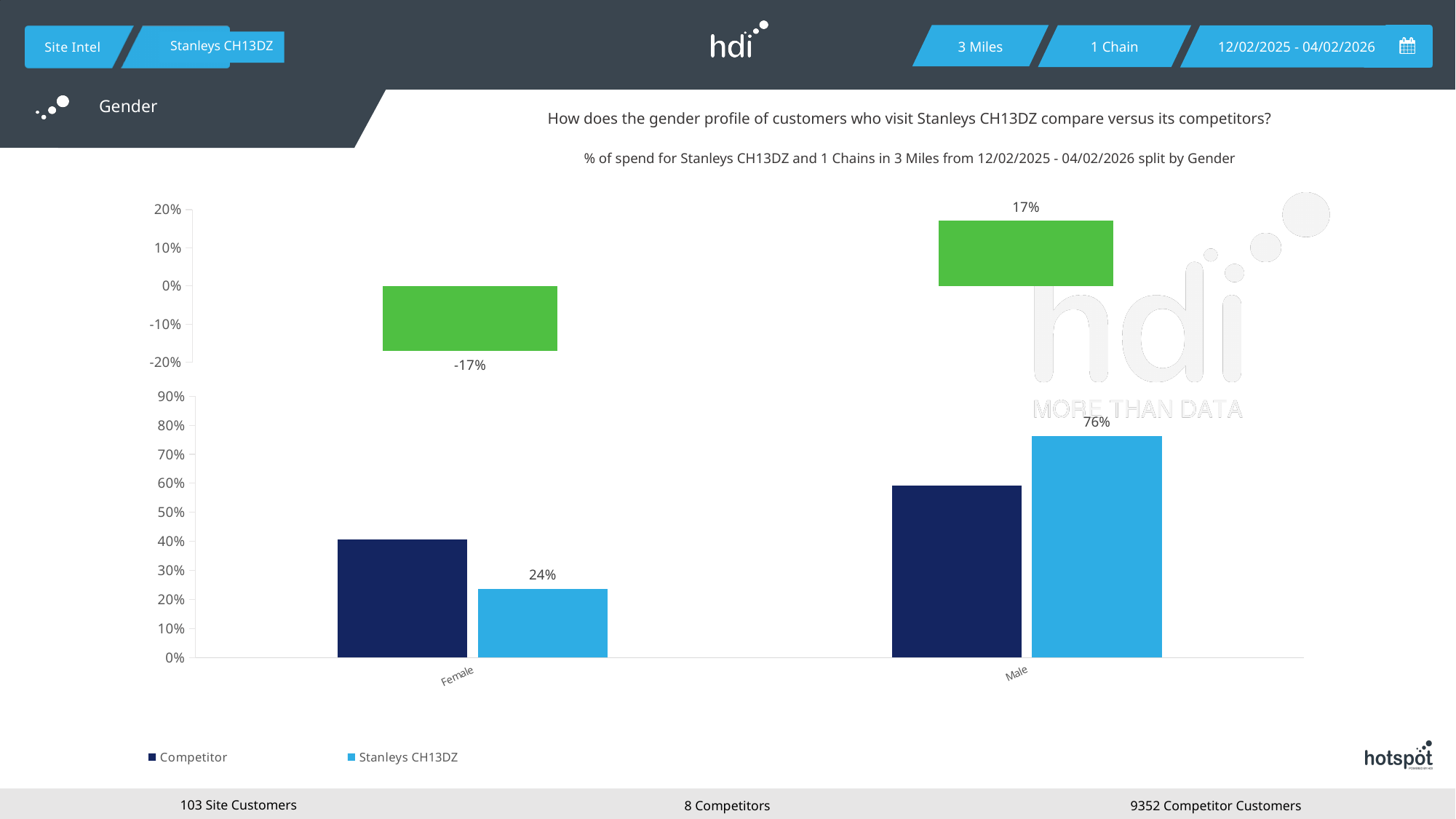
In the top chart, what is the value shown for the Male category? 17% In the bottom chart, is the Competitor value for Male greater or less than 50%? greater In the bottom chart, what is the value for Stanleys CH13DZ in the Male category? 76% In the bottom chart, what is the value for Stanleys CH13DZ in the Female category? 24% What kind of chart is the bottom chart? bar chart How many categories are shown on the x axis of the bottom chart? 2 In the top chart, what is the value shown for the Female category? -17% In the bottom chart, what is the difference between the Stanleys CH13DZ Male value and the Stanleys CH13DZ Female value? 52% In the bottom chart, which is larger for the Male category: Competitor or Stanleys CH13DZ? Stanleys CH13DZ In the bottom chart, is the Competitor value for Female greater or less than 50%? less In the bottom chart, which is larger for the Female category: Competitor or Stanleys CH13DZ? Competitor How many series does the legend of the bottom chart list? 2